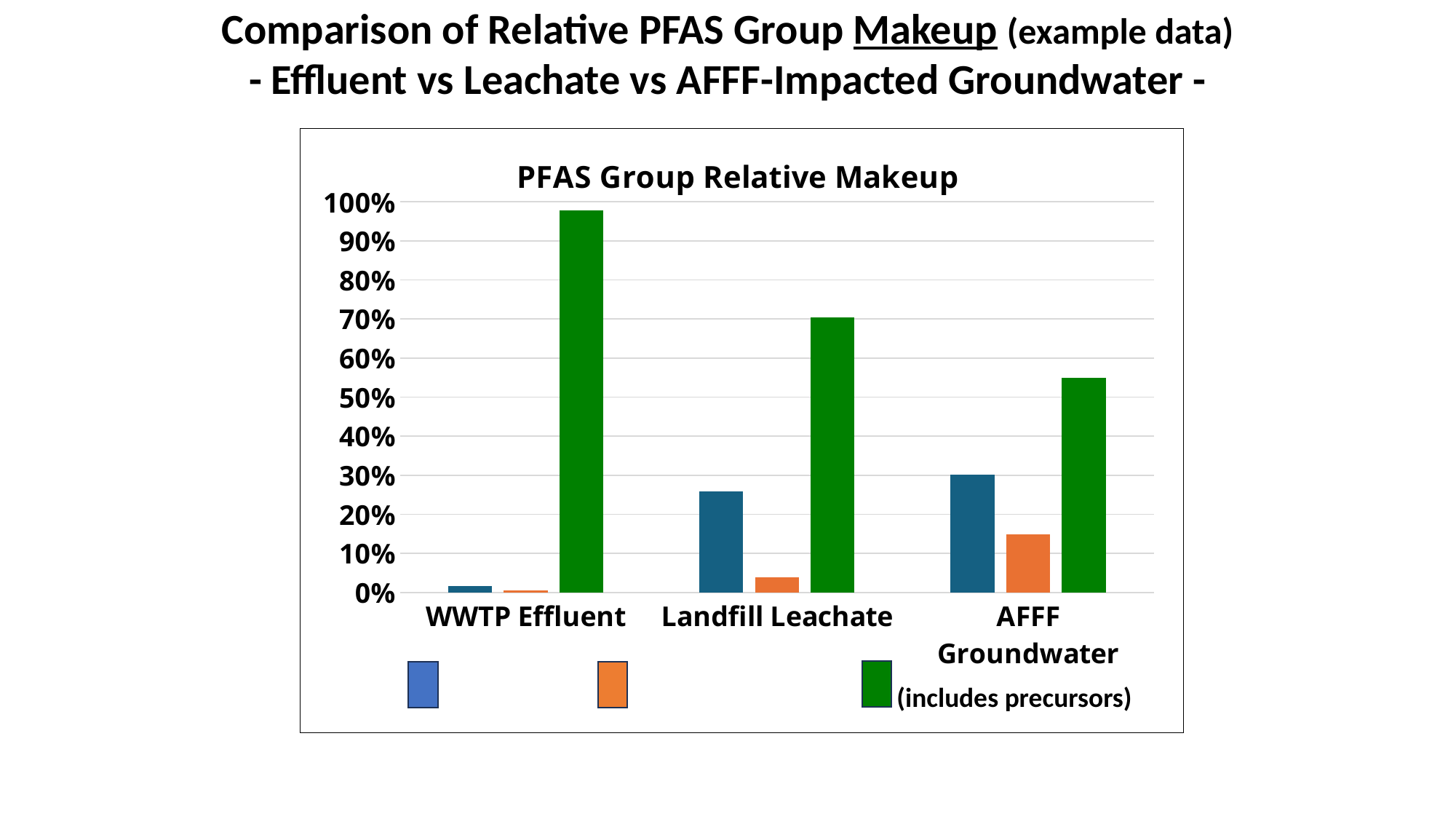
Is the green bar for WWTP Effluent greater or less than 90%? greater How many series does the chart's legend list? 3 Which category has the lowest green bar (includes precursors)? AFFF Groundwater How many categories are shown on the x axis of the chart? 3 Which colour series in the legend is labelled "(includes precursors)"? green Which has the larger orange bar, Landfill Leachate or AFFF Groundwater? AFFF Groundwater What kind of chart is shown on the slide? bar chart Which category has the highest green bar (includes precursors)? WWTP Effluent Is the blue bar for AFFF Groundwater greater or less than 20%? greater What is the title shown inside the chart area? PFAS Group Relative Makeup Is the green bar for Landfill Leachate greater or less than 60%? greater